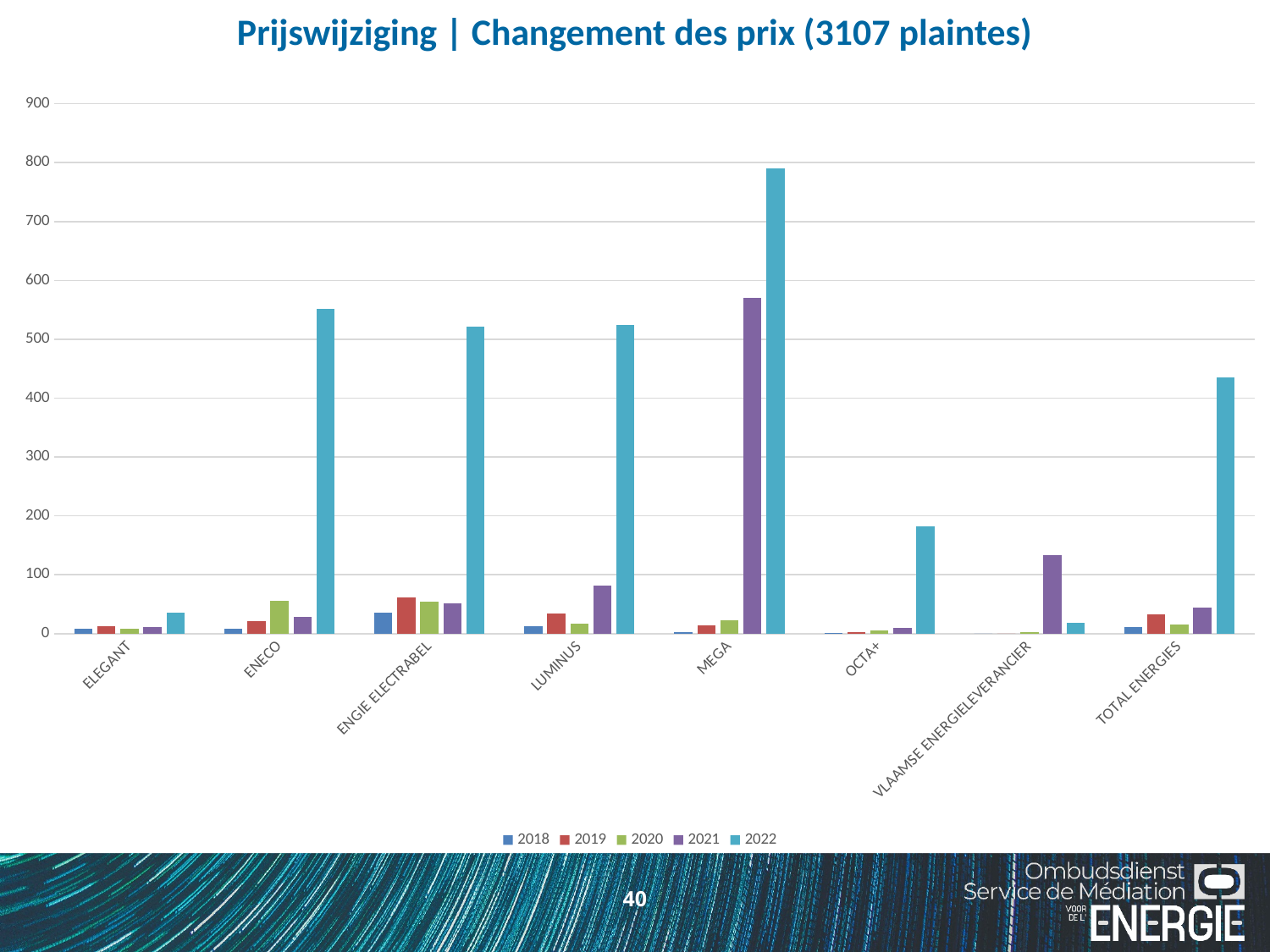
Is the 2021 value for MEGA greater or less than 500? greater What kind of chart is shown on the slide? bar chart Is the 2022 value for OCTA+ greater or less than 200? less For MEGA, which year has the highest bar? 2022 Is the 2022 value for ENECO greater or less than 500? greater How many series does the legend list? 5 What is the title of the chart? Prijswijziging | Changement des prix (3107 plaintes) How many suppliers (categories) are shown on the x axis? 8 Which supplier has the highest bar for 2022? MEGA For VLAAMSE ENERGIELEVERANCIER, which is larger: the 2021 value or the 2022 value? 2021